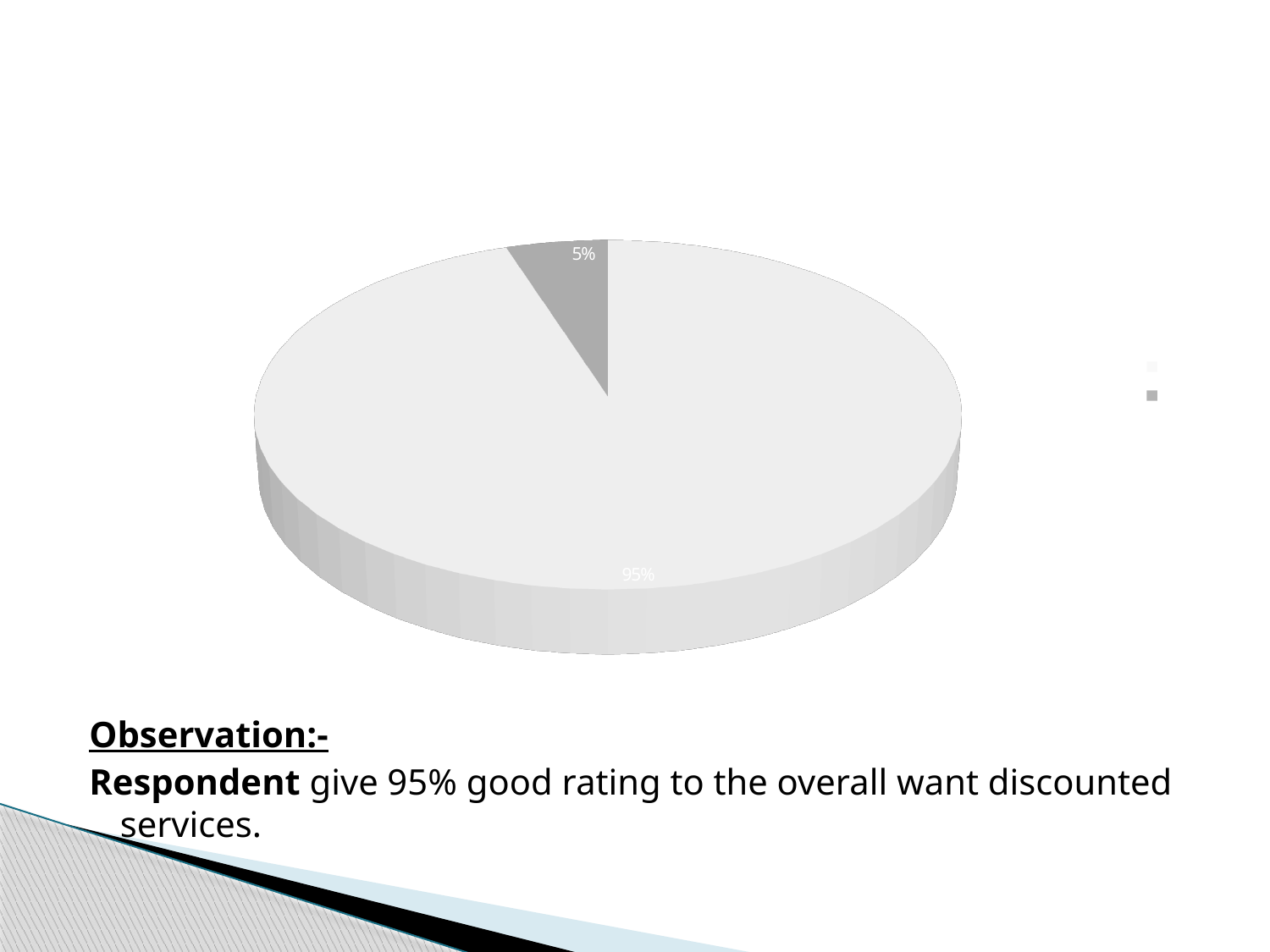
Which slice is larger, the light grey slice or the dark grey slice? the light grey slice What colour is the slice labelled 5%? dark grey Is the largest slice of the pie chart greater or less than 50%? greater What is the value of the smallest slice of the pie chart? 5% What is the difference between the two slices of the pie chart? 90 percentage points What share of the pie does the dark grey slice represent? 5% What kind of chart is shown on the slide? pie chart How many slices does the pie chart have? 2 What is the value of the largest slice of the pie chart? 95% What do the two slices of the pie chart add up to? 100%